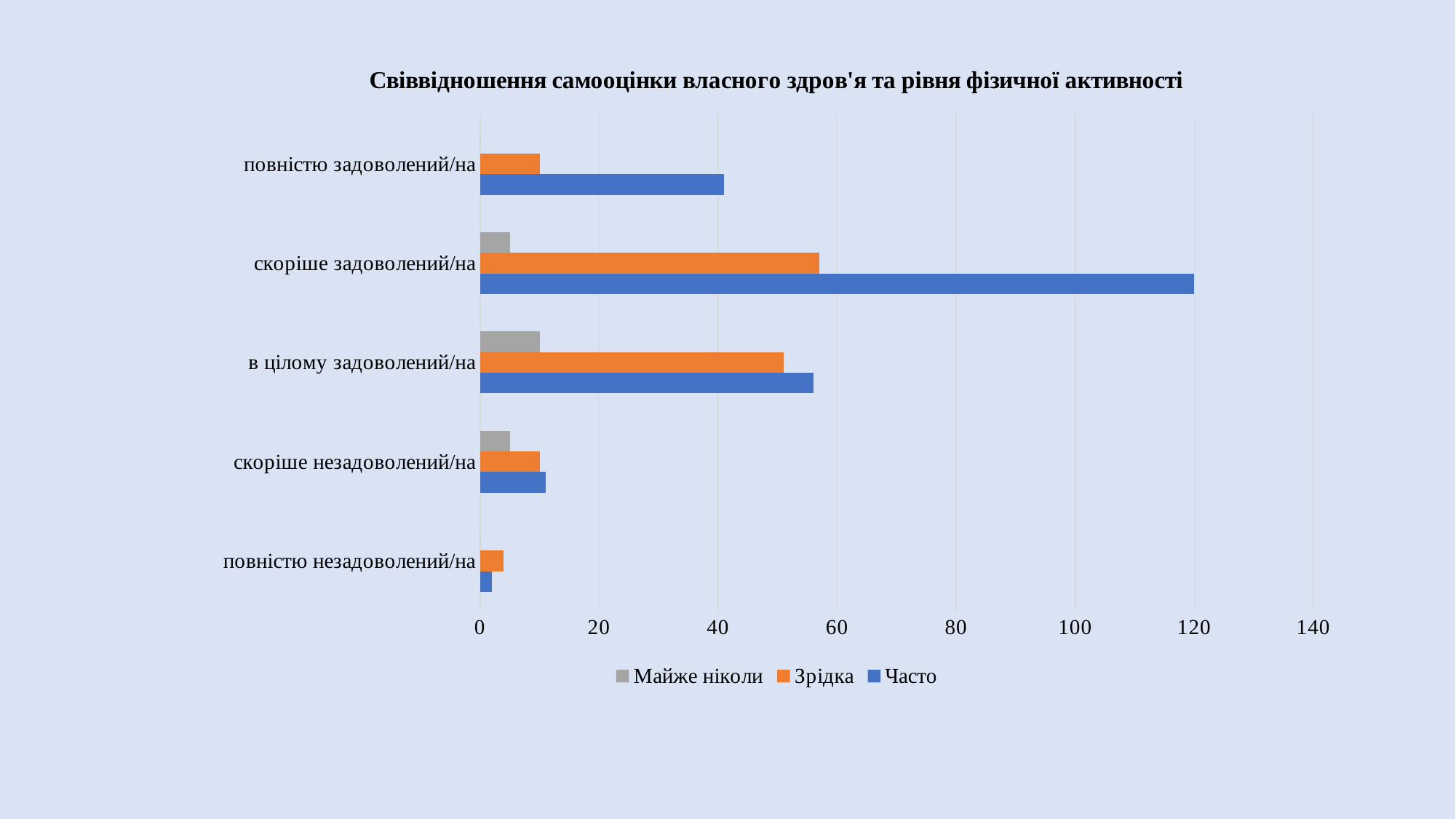
How many series does the legend list? 3 Is the value of 'Часто' for 'скоріше незадоволений/на' greater or less than 20? less Which category has the highest value for the 'Часто' series? скоріше задоволений/на What is the title of the chart? Свіввідношення самооцінки власного здров'я та рівня фізичної активності How many categories are shown on the vertical axis? 5 What is the value of the 'Часто' series for 'скоріше задоволений/на'? 120 Which category has the highest value for the 'Зрідка' series? скоріше задоволений/на For 'в цілому задоволений/на', which is larger: the 'Часто' value or the 'Майже ніколи' value? Часто Is the value of 'Зрідка' for 'в цілому задоволений/на' greater or less than 60? less Which category has the lowest value for the 'Часто' series? повністю незадоволений/на What kind of chart is shown on the slide? bar chart